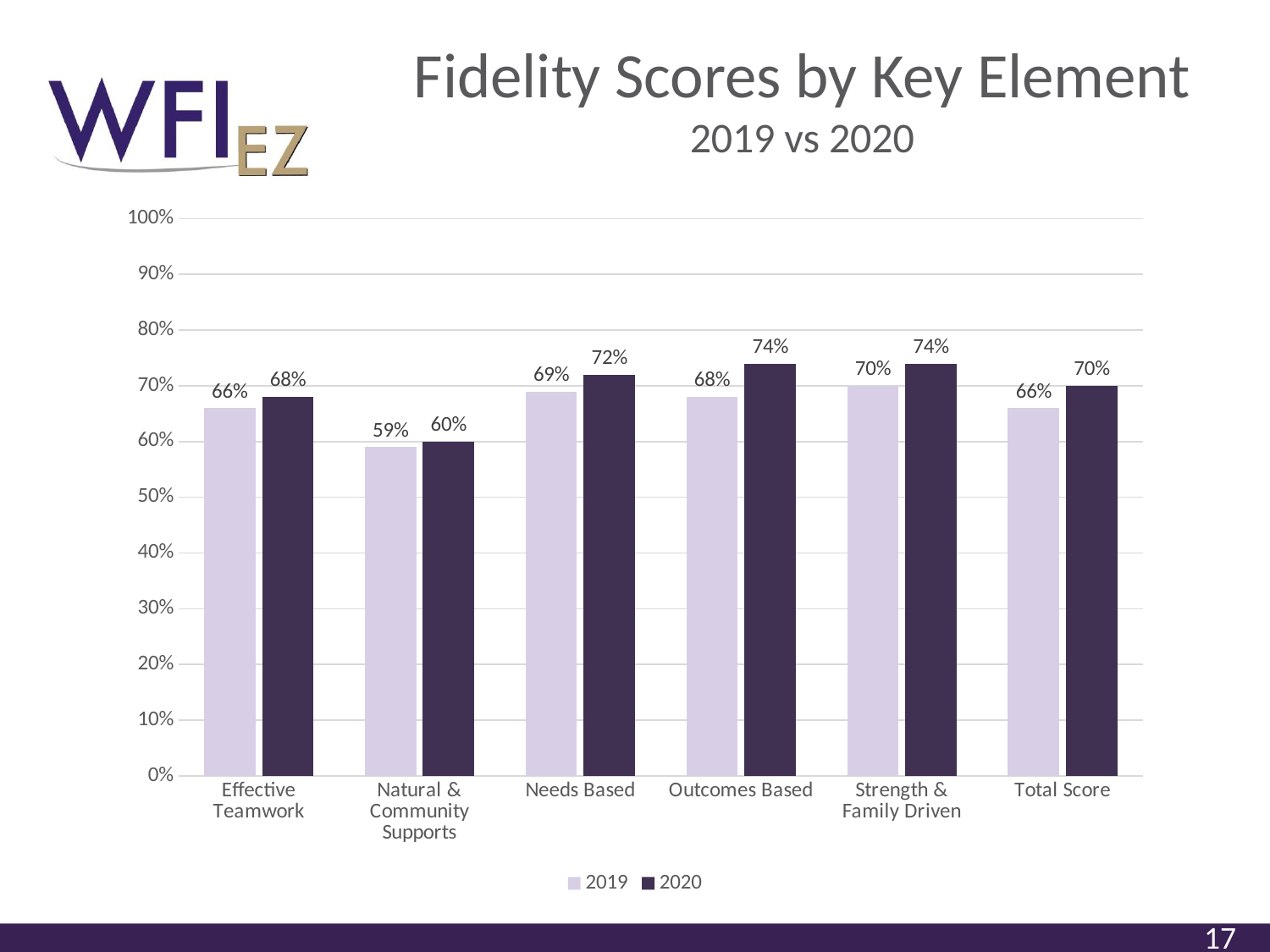
What is the 2020 fidelity score for Needs Based? 72% What is the 2019 fidelity score for Natural & Community Supports? 59% What is the difference between the 2020 and 2019 scores for Outcomes Based? 6% What kind of chart is shown on the slide? Bar chart What is the 2019 value for Total Score? 66% How many key element categories are shown on the x axis? 6 What are the two series named in the legend? 2019 and 2020 Which is larger, the 2019 score for Needs Based or the 2019 score for Effective Teamwork? Needs Based Which key element has the lowest 2019 score? Natural & Community Supports Which key element has the lowest 2020 score? Natural & Community Supports How many series does the legend list? 2 What is the difference between the 2020 and 2019 scores for Strength & Family Driven? 4%